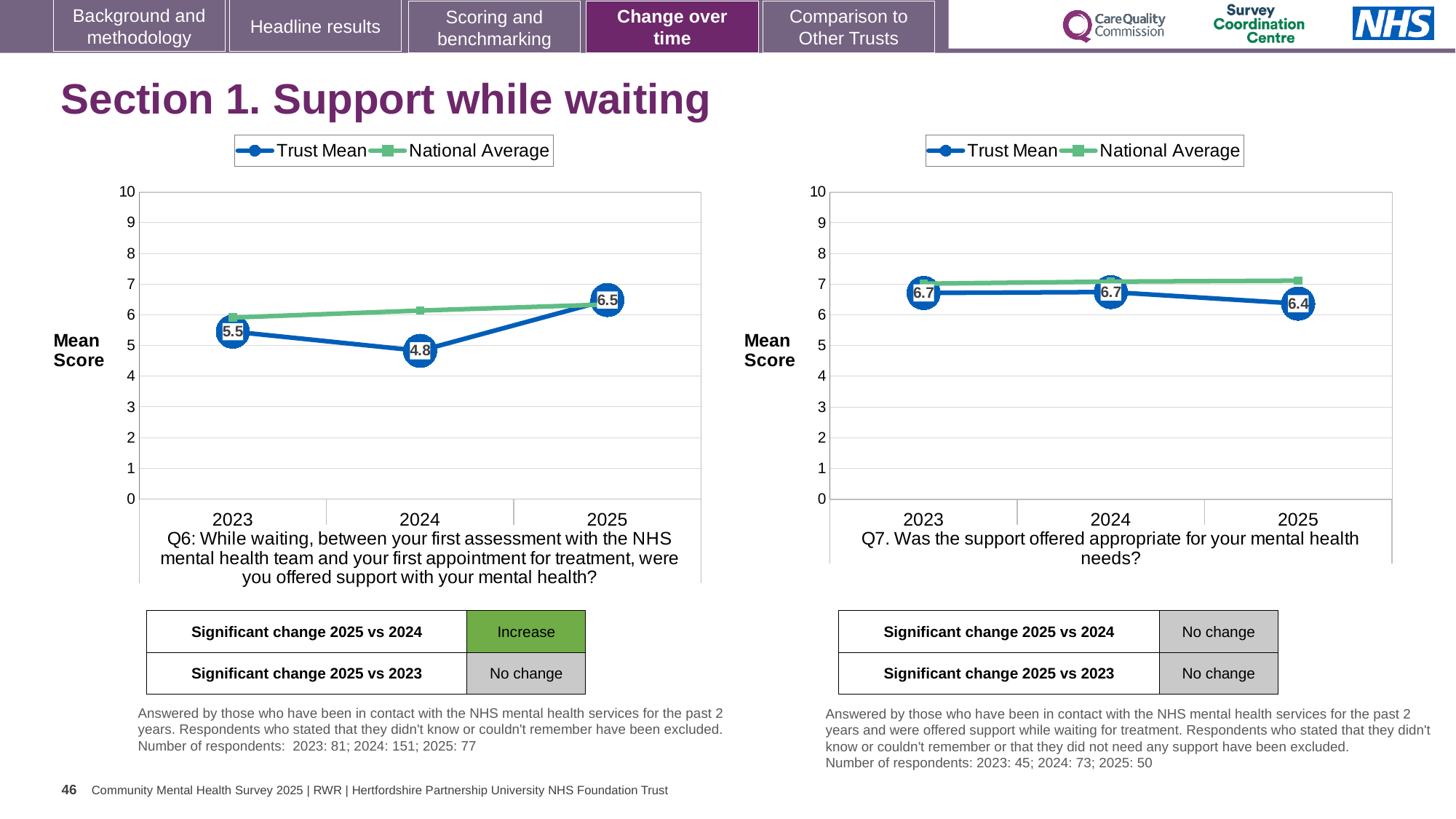
On the left chart (Q6), what is the Trust Mean score for 2024? 4.8 On the right chart (Q7), is the Trust Mean for 2025 greater or less than 7? less On the left chart (Q6), which year has the lowest Trust Mean score? 2024 On the left chart (Q6), what is the Trust Mean score for 2025? 6.5 On the left chart (Q6), what is the difference between the Trust Mean scores for 2025 and 2024? 1.7 On the left chart (Q6), which year has the highest Trust Mean score? 2025 On the left chart (Q6), which is larger in 2024: the Trust Mean or the National Average? National Average What type of chart is the left chart (Q6)? Line chart On the right chart (Q7), what is the difference between the Trust Mean scores for 2023 and 2025? 0.3 How many series does the legend of the right chart (Q7) list? 2 On the right chart (Q7), what is the Trust Mean score for 2025? 6.4 On the left chart (Q6), is the National Average for 2023 greater or less than 5? greater